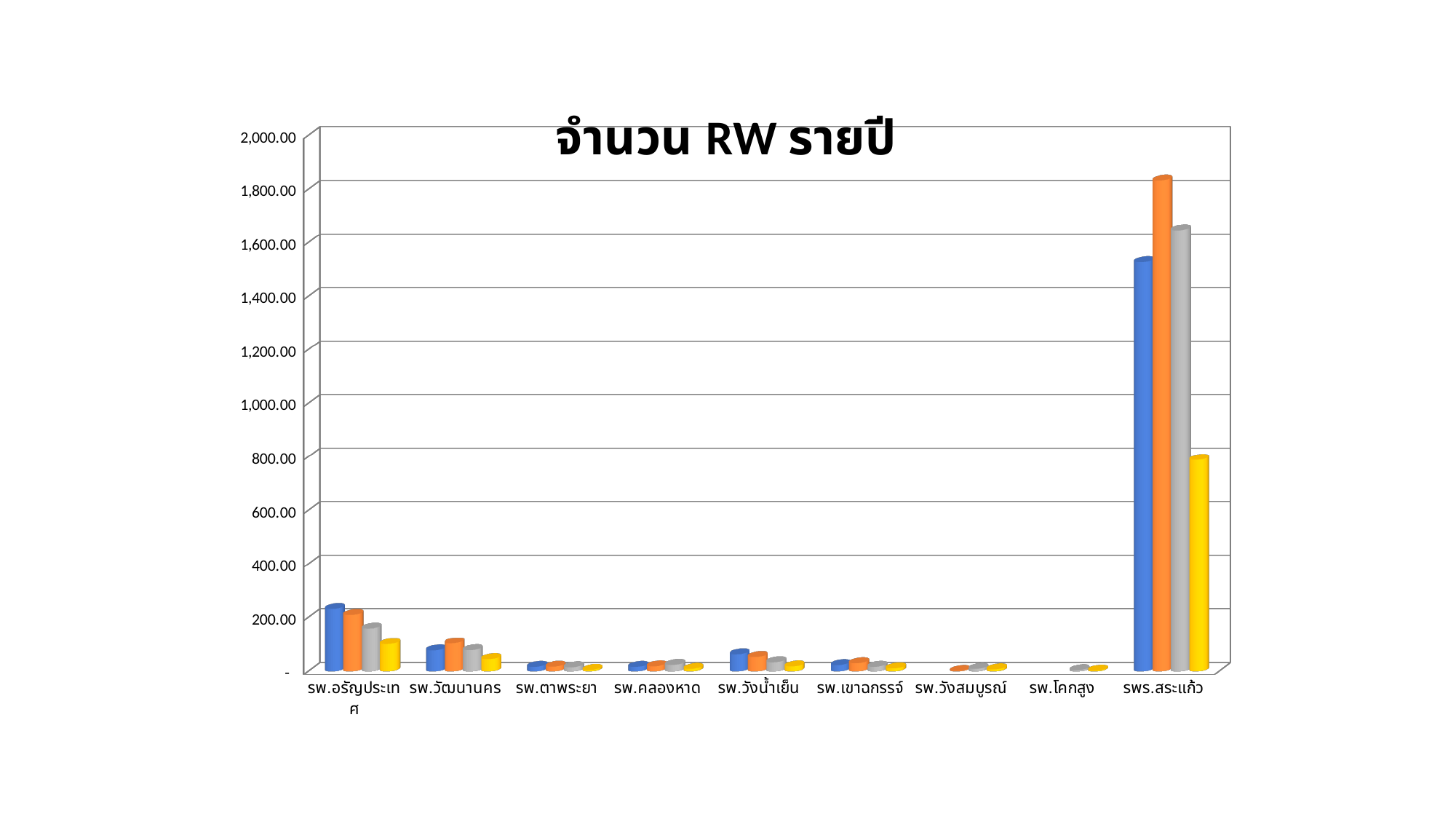
Is the value of the orange bar for รพร.สระแก้ว greater or less than 1,600.00? greater How many bars are plotted for each category? 4 What kind of chart is shown on the slide? bar chart Which category has larger bars: รพ.อรัญประเทศ or รพ.ตาพระยา? รพ.อรัญประเทศ How many categories are shown along the x axis? 9 Is the value of the gray bar for รพร.สระแก้ว greater or less than 1,400.00? greater Which category has the highest bars in the chart? รพร.สระแก้ว Which category has the lowest bars in the chart? รพ.โคกสูง Is the value of the yellow bar for รพร.สระแก้ว greater or less than 1,000.00? less For รพร.สระแก้ว, which is larger: the orange bar or the yellow bar? the orange bar What is the title of the chart? จำนวน RW รายปี